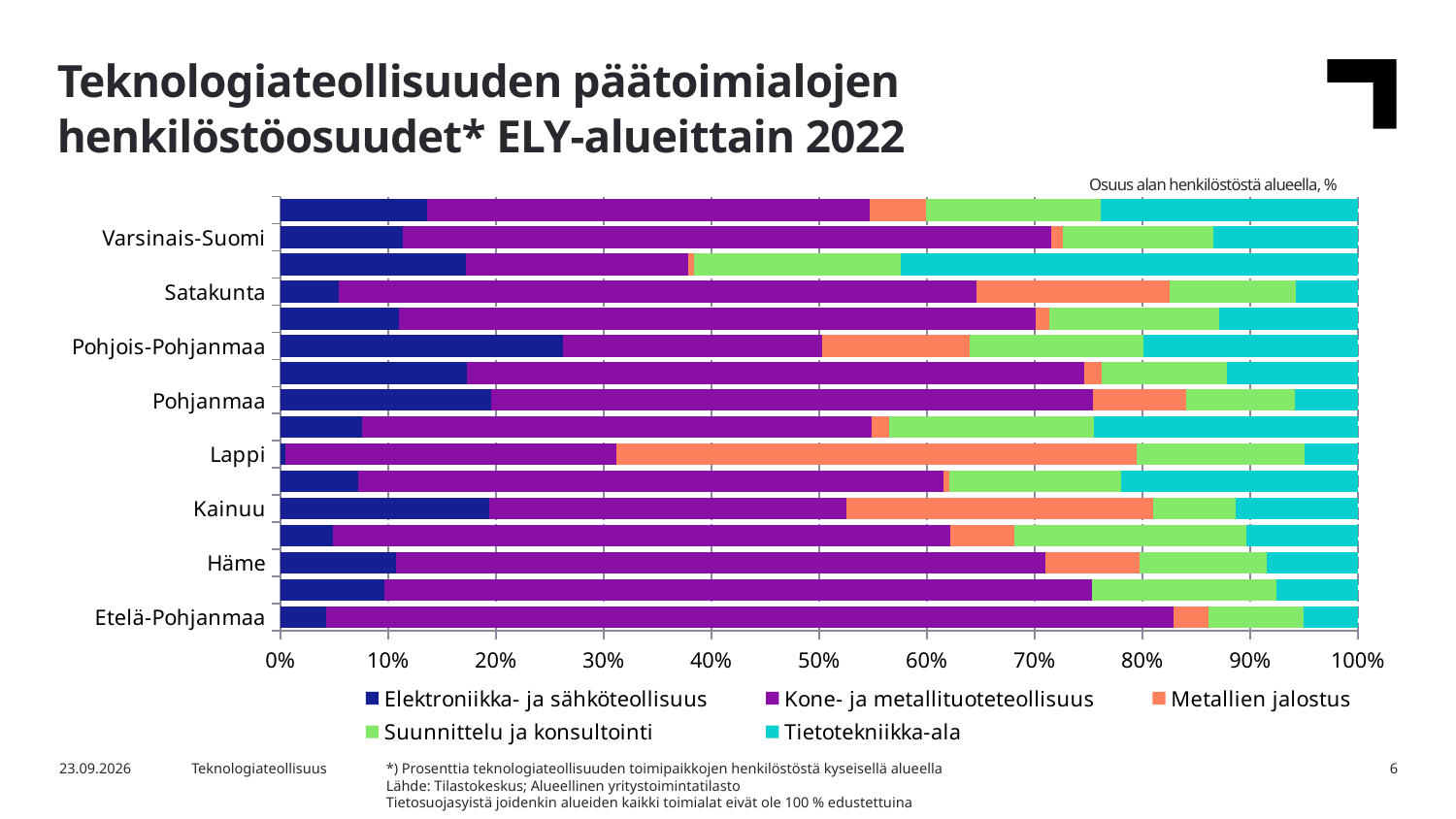
Which series is shown in orange in the legend? Metallien jalostus How many series does the legend list? 5 Which region has the largest Elektroniikka- ja sähköteollisuus share? Pohjois-Pohjanmaa What is the label printed above the top right of the chart describing the values? Osuus alan henkilöstöstä alueella, % Which has the larger Elektroniikka- ja sähköteollisuus share, Pohjois-Pohjanmaa or Satakunta? Pohjois-Pohjanmaa What kind of chart is shown on the slide? Stacked bar chart Is the Kone- ja metallituoteteollisuus share for Lappi greater or less than 40%? less Is the Metallien jalostus share for Lappi greater or less than 40%? greater Is the Elektroniikka- ja sähköteollisuus share for Pohjois-Pohjanmaa greater or less than 20%? greater Which region has the largest Metallien jalostus share? Lappi Which region has the largest Kone- ja metallituoteteollisuus share? Etelä-Pohjanmaa